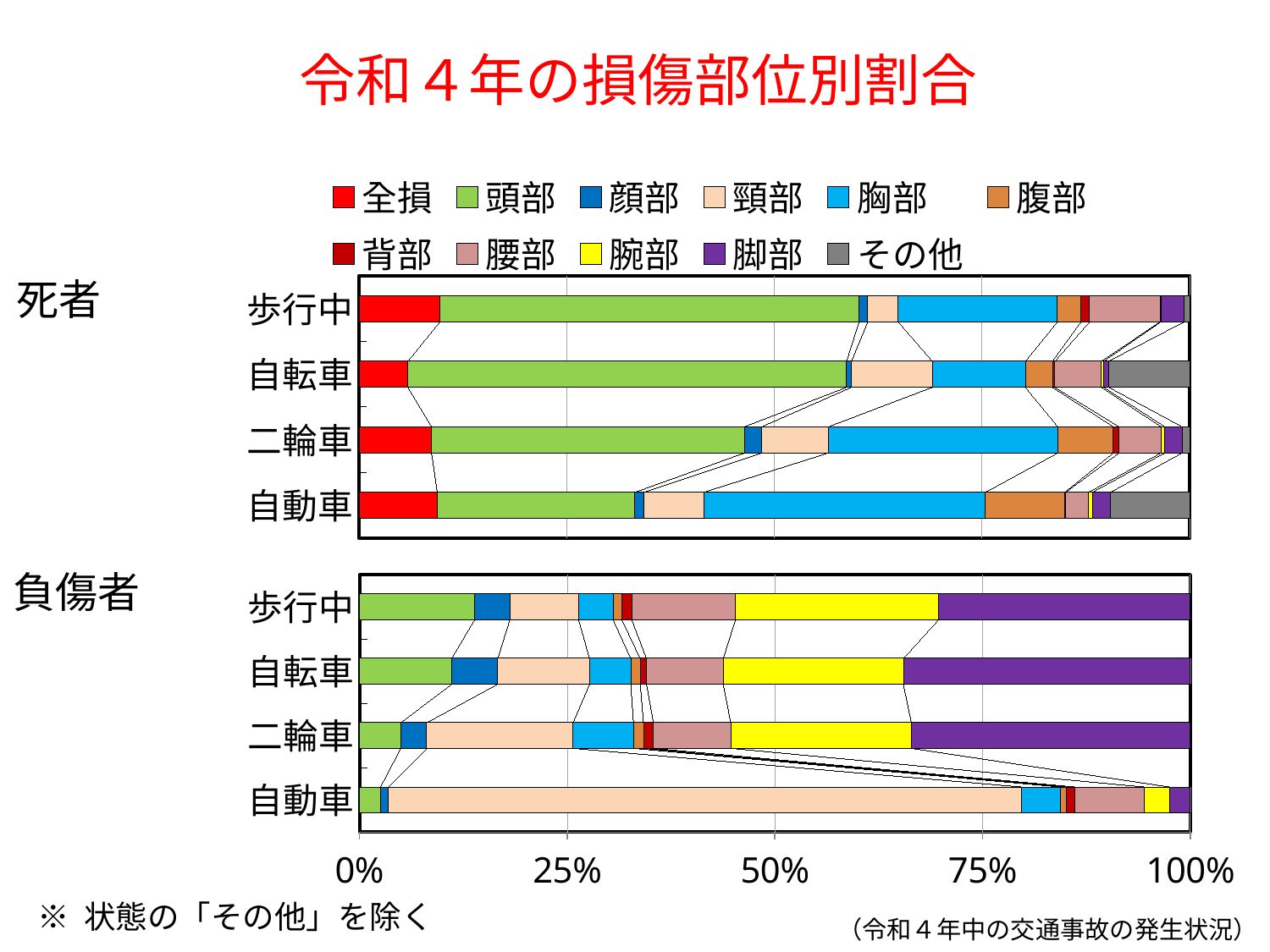
In the 負傷者 chart, which category has the smallest 頭部 segment? 自動車 What kind of chart is used on this slide for the 死者 and 負傷者 data? Stacked bar chart In the 負傷者 chart, which category has the largest 頸部 segment? 自動車 In the 負傷者 chart, which has the larger 頸部 segment, 自動車 or 歩行中? 自動車 In the 負傷者 chart, is the 頸部 segment for 自動車 greater or less than 50%? greater In the legend, which colour represents 腕部? Yellow In the 死者 chart, is the 頭部 segment for 歩行中 greater or less than 25%? greater In the 死者 chart, which has the larger 頭部 segment, 歩行中 or 自動車? 歩行中 What is the title of the slide's chart? 令和４年の損傷部位別割合 How many series does the legend list? 11 How many categories (rows) does the 死者 chart show? 4 In the 負傷者 chart, is the 脚部 segment for 自動車 greater or less than 25%? less